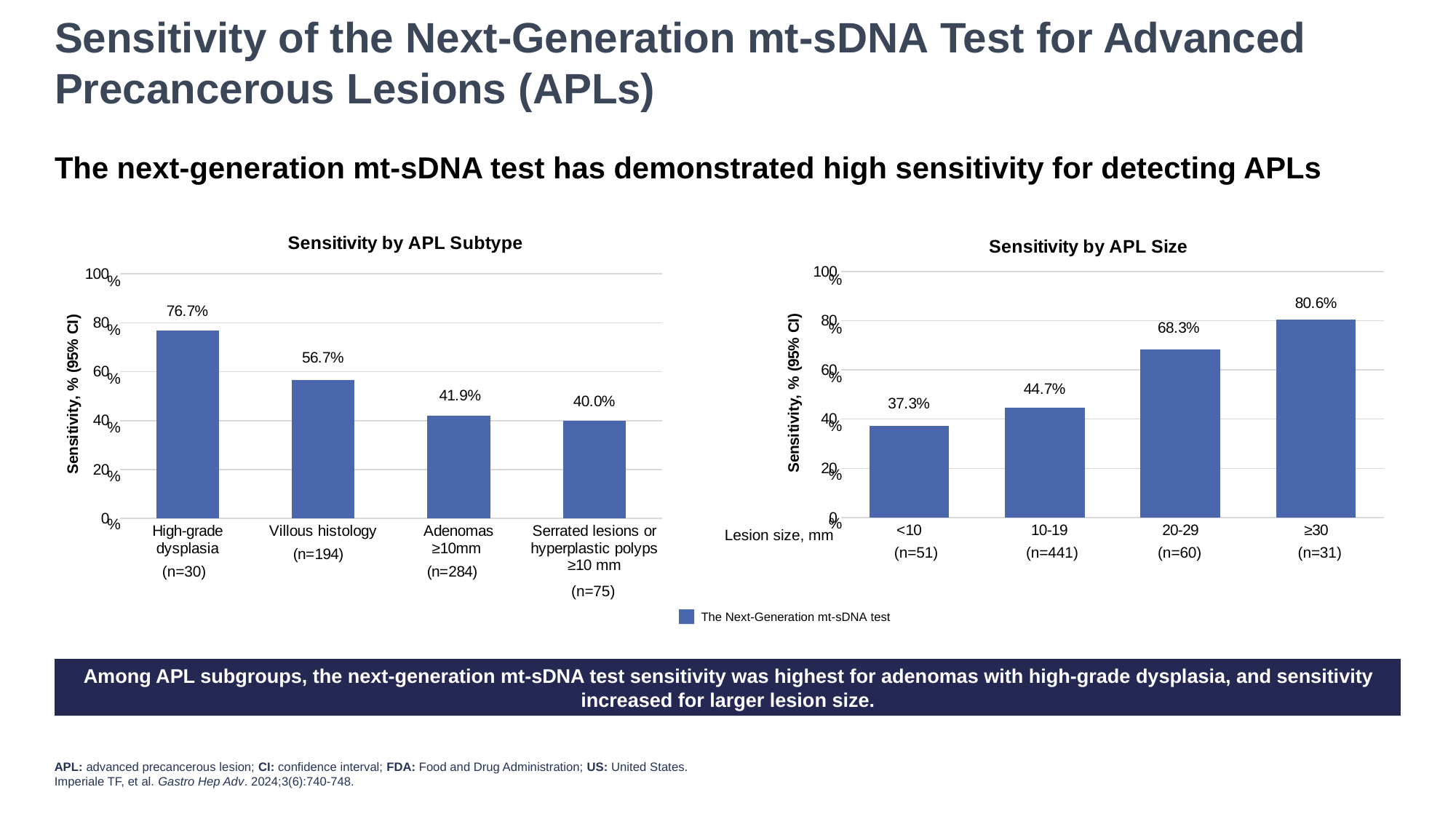
In the 'Sensitivity by APL Size' chart, which is larger: the sensitivity for 10-19 mm or for 20-29 mm lesions? 20-29 In the 'Sensitivity by APL Size' chart, do the sensitivity values rise or fall as lesion size increases along the x axis? rise In the 'Sensitivity by APL Subtype' chart, which category has the lowest sensitivity? Serrated lesions or hyperplastic polyps ≥10 mm How many series does the legend list? 1 In the 'Sensitivity by APL Size' chart, what is the sensitivity for lesions 20-29 mm? 68.3% In the 'Sensitivity by APL Size' chart, what is the difference in sensitivity between the ≥30 and <10 lesion size groups? 43.3% In the 'Sensitivity by APL Size' chart, which lesion size category has the highest sensitivity? ≥30 In the 'Sensitivity by APL Subtype' chart, what is the sensitivity for High-grade dysplasia? 76.7% In the 'Sensitivity by APL Subtype' chart, what is the difference in sensitivity between High-grade dysplasia and Adenomas ≥10mm? 34.8% In the 'Sensitivity by APL Subtype' chart, what is the sensitivity for Villous histology? 56.7% In the 'Sensitivity by APL Subtype' chart, how many categories are shown? 4 What kind of chart is 'Sensitivity by APL Subtype'? bar chart